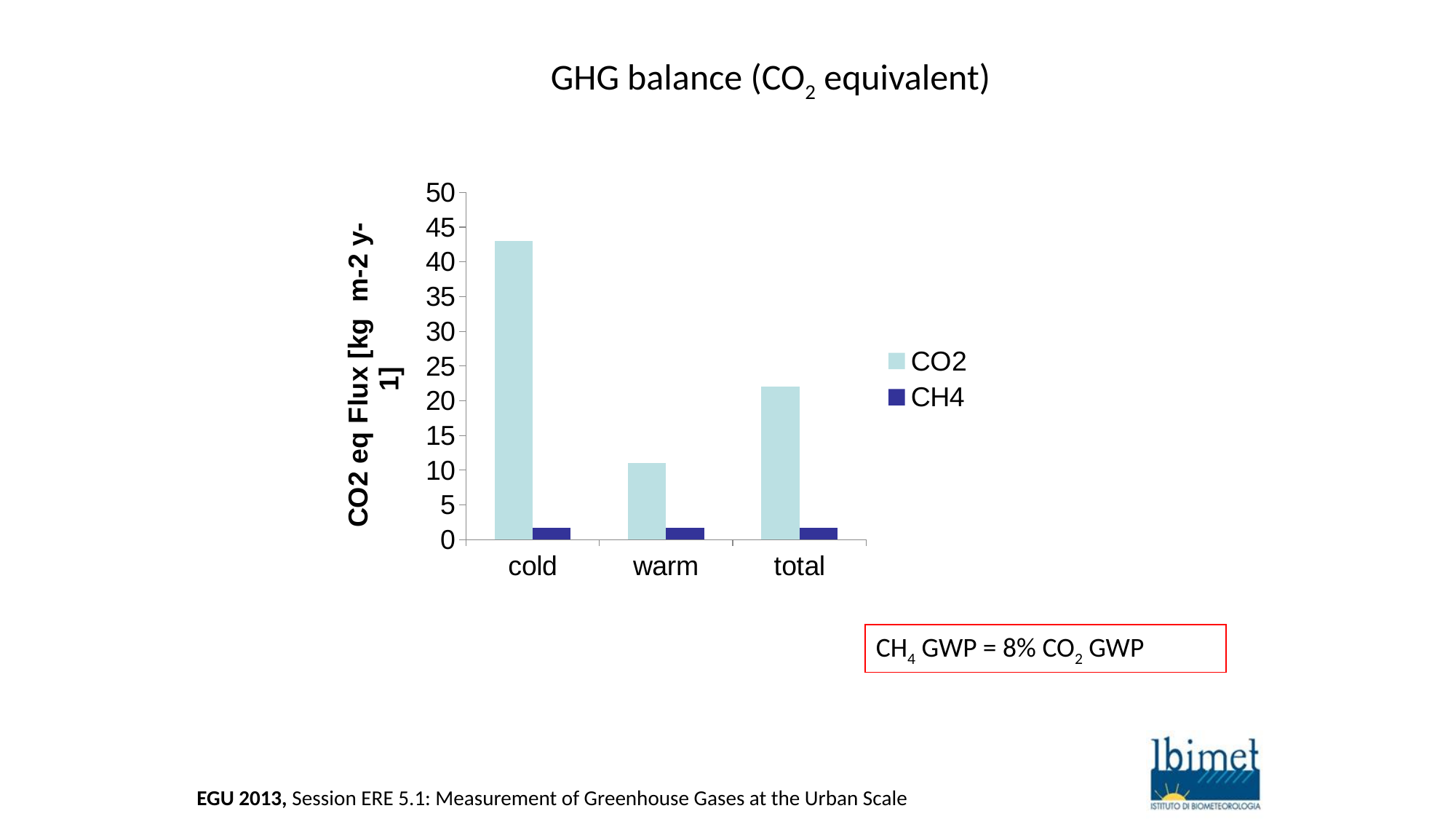
Is the CO2 value for total greater or less than 20? greater Which is larger for the warm category, CO2 or CH4? CO2 Is the CO2 value for cold greater or less than 40? greater How many categories are shown on the x axis? 3 Which category has the lowest CO2 value? warm What is the title of the chart? GHG balance (CO2 equivalent) Is the CO2 value for warm greater or less than 15? less What kind of chart is shown on the slide? bar chart Which is larger, the CO2 value for cold or the CO2 value for total? cold How many series does the legend list? 2 Which category has the highest CO2 value? cold